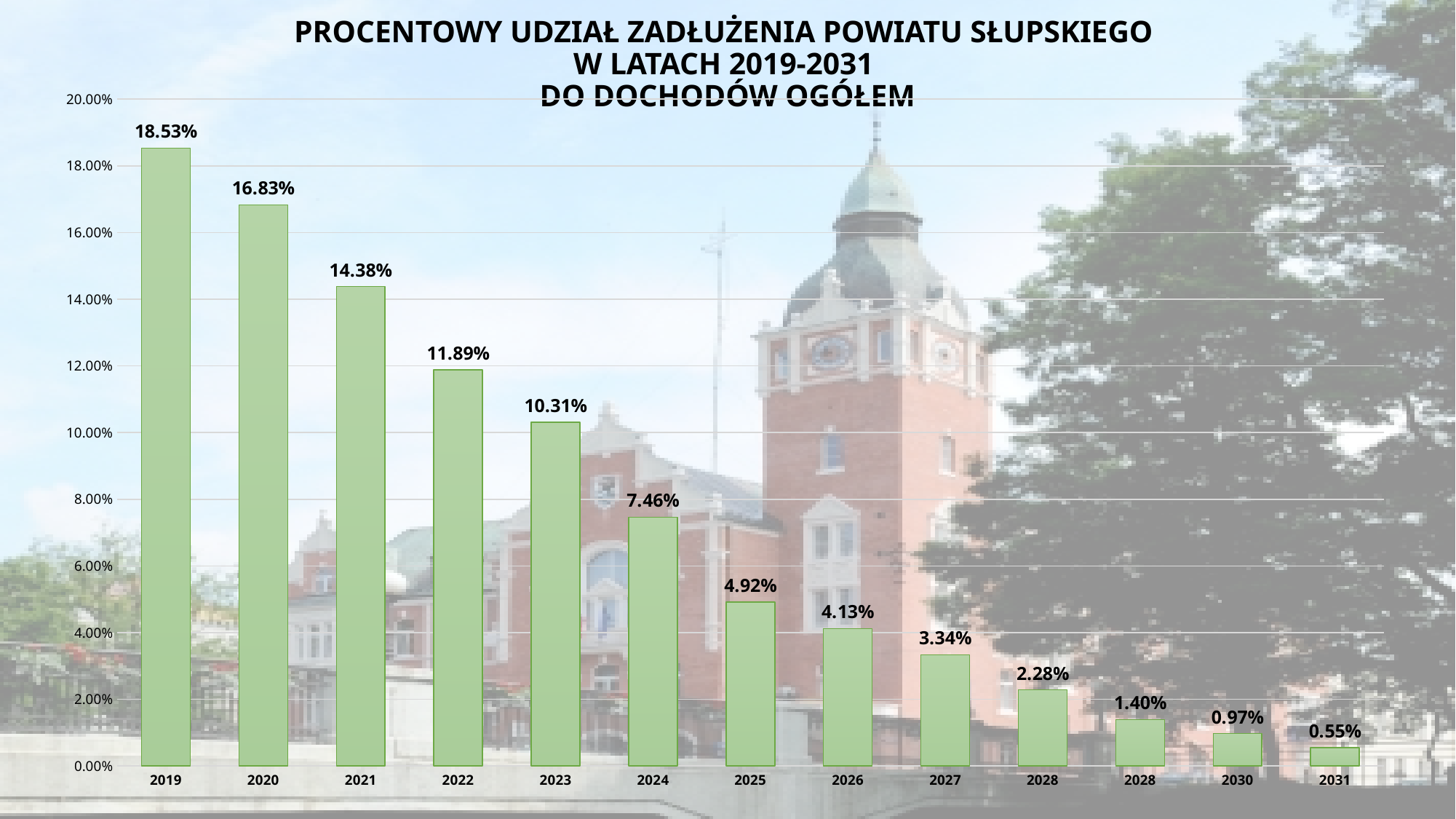
Which is larger, the value for 2021 or the value for 2026? 2021 What kind of chart is shown on the slide? bar chart Do the values rise or fall from 2019 to 2031? fall Which year has the lowest value? 2031 Is the value for 2024 greater or less than 8.00%? less What is the value for 2019? 18.53% What is the value for 2022? 11.89% What is the difference between the values for 2023 and 2024? 2.85% Which year has the highest value? 2019 What is the value for 2025? 4.92% What is the value for 2031? 0.55% What is the difference between the values for 2019 and 2020? 1.70%